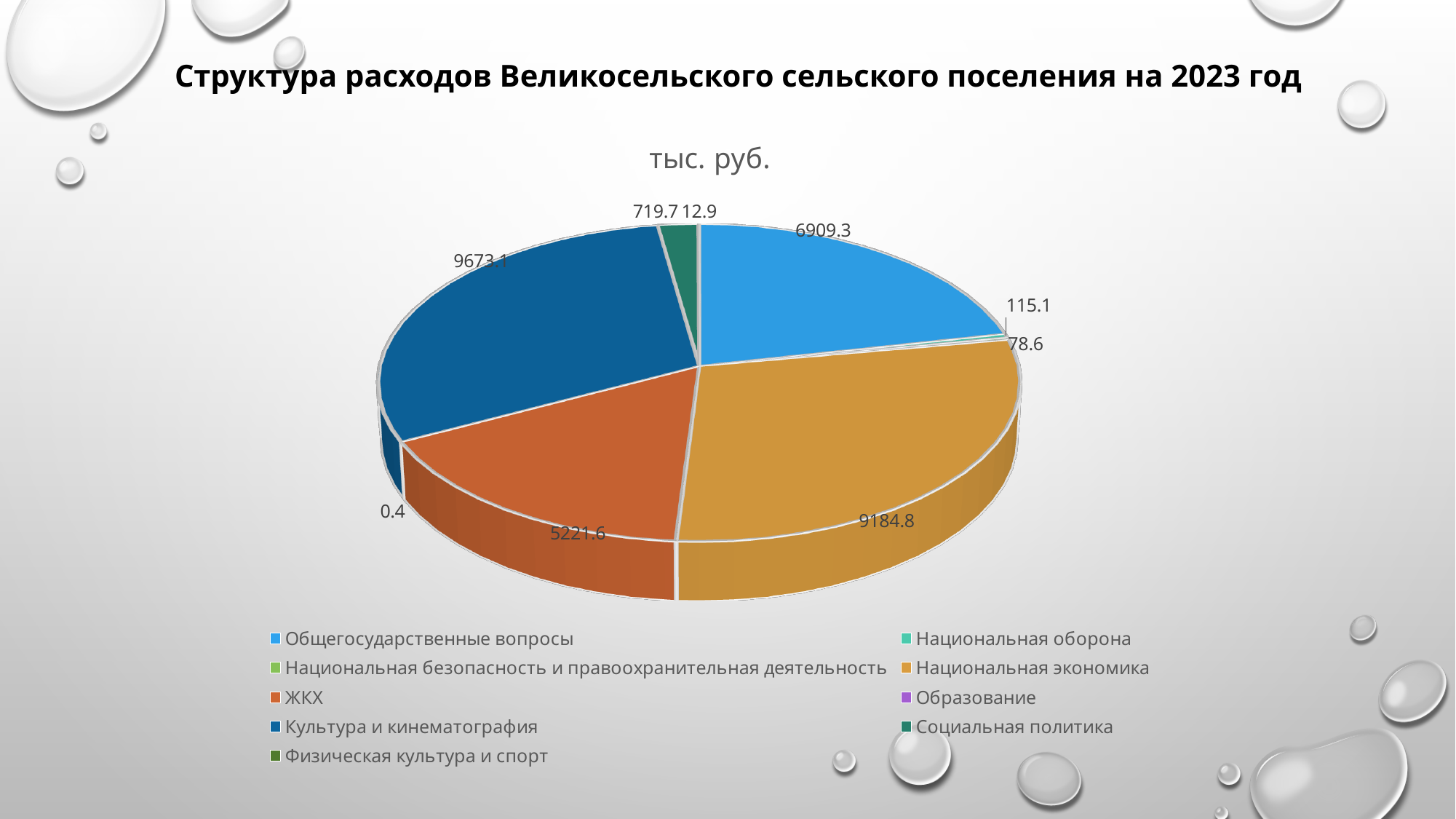
What is the title shown above the pie chart? тыс. руб. What is the difference between the values for Культура и кинематография and Национальная экономика? 488.3 Which category has the largest slice? Культура и кинематография What kind of chart is shown on the slide? pie chart What is the value for Социальная политика? 719.7 Which category has the smallest slice? Образование What is the value for ЖКХ? 5221.6 What is the value for Национальная оборона? 115.1 What is the value for Общегосударственные вопросы? 6909.3 What is the value for Национальная экономика? 9184.8 How many categories does the legend list? 9 Which is larger, the value for Общегосударственные вопросы or the value for ЖКХ? Общегосударственные вопросы